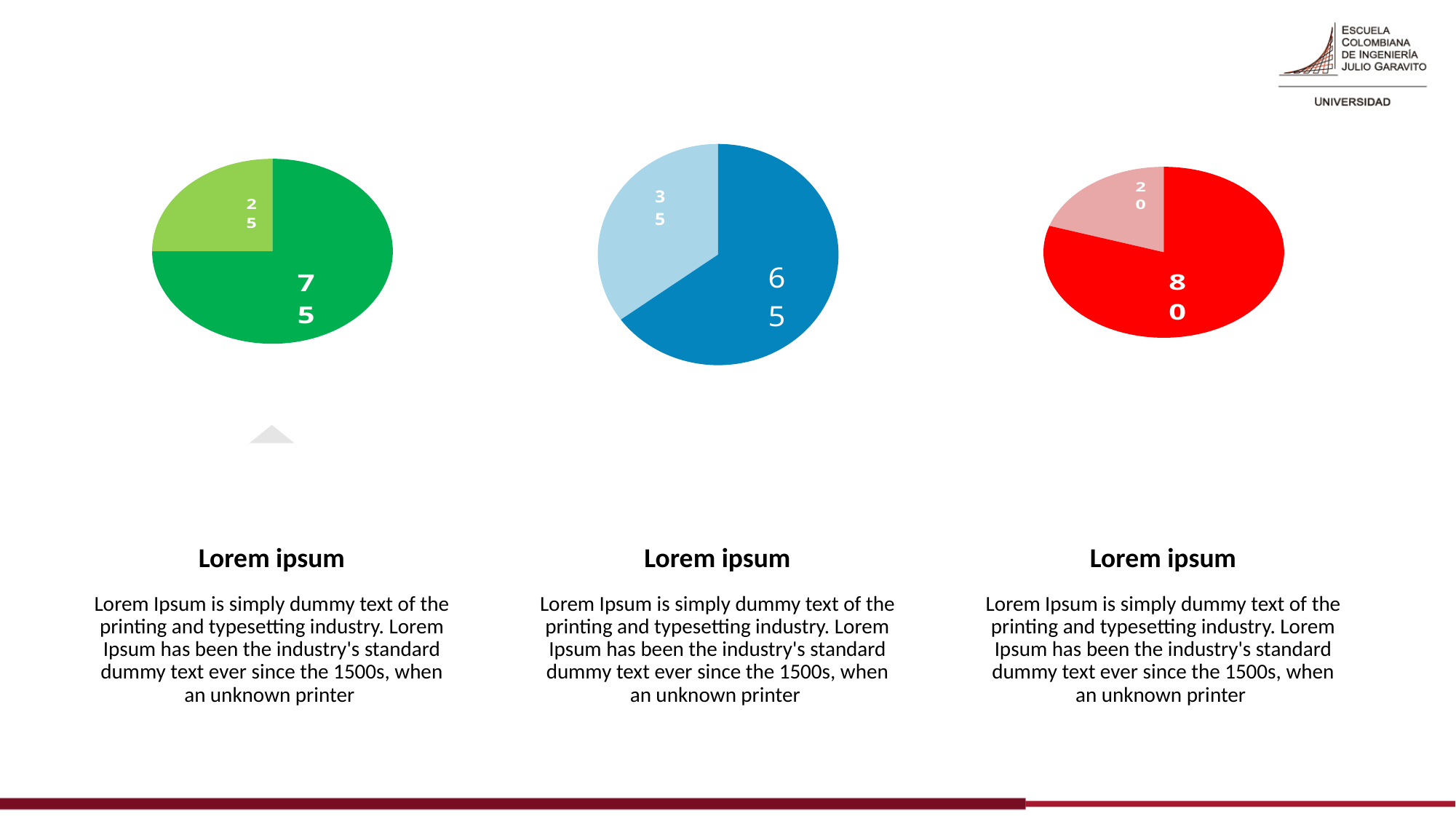
In the left-hand pie chart, what share of the total does the dark green slice represent? 75% How many slices does the middle pie chart have? 2 In the right-hand pie chart, which slice is larger, the red one or the pink one? the red one What kind of chart is the left-hand chart on the slide? pie chart How many pie charts are shown on the slide? 3 In the middle pie chart, what is the difference between the dark blue slice and the light blue slice? 30 In the left-hand pie chart, what value is printed on the light green slice? 25 In the left-hand pie chart, what value is printed on the dark green slice? 75 In the middle pie chart, what value is printed on the dark blue slice? 65 In the right-hand pie chart, what value is printed on the red slice? 80 In the middle pie chart, what value is printed on the light blue slice? 35 In the right-hand pie chart, what value is printed on the pink slice? 20